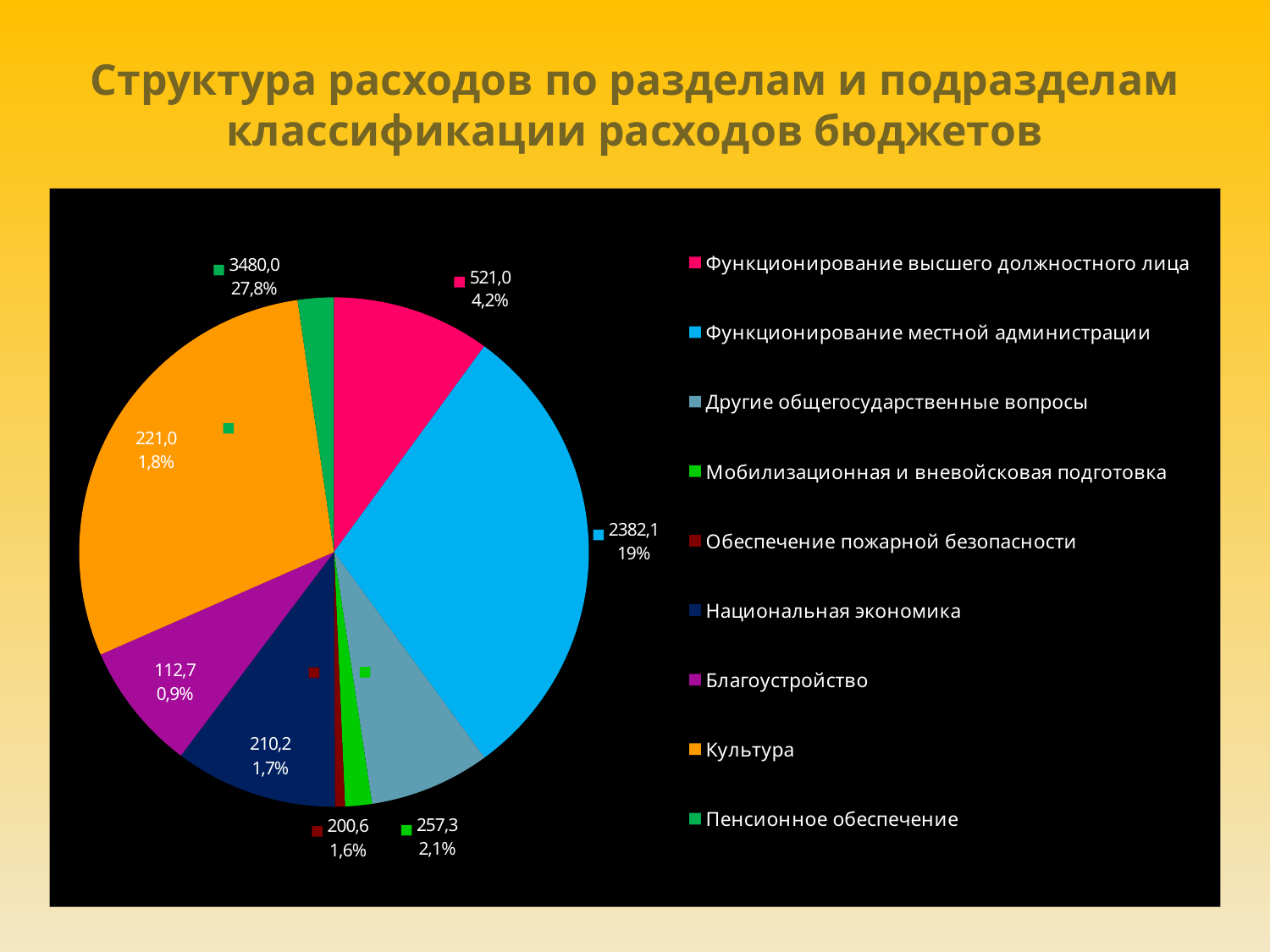
What percentage is shown for Обеспечение пожарной безопасности? 1,6% What is the title of the slide containing the pie chart? Структура расходов по разделам и подразделам классификации расходов бюджетов What percentage is shown for Функционирование высшего должностного лица? 4,2% Which is larger, the value for Функционирование местной администрации or for Функционирование высшего должностного лица? Функционирование местной администрации What is the difference between the values for Функционирование местной администрации (2382,1) and Функционирование высшего должностного лица (521,0)? 1861,1 What kind of chart is shown on the slide? Pie chart What value is shown for Мобилизационная и вневойсковая подготовка? 257,3 How many categories does the legend of the pie chart list? 9 What percentage is shown for Функционирование местной администрации? 19% What value is shown for Функционирование местной администрации? 2382,1 What colour represents Культура in the pie chart legend? Orange What value is shown for Функционирование высшего должностного лица? 521,0